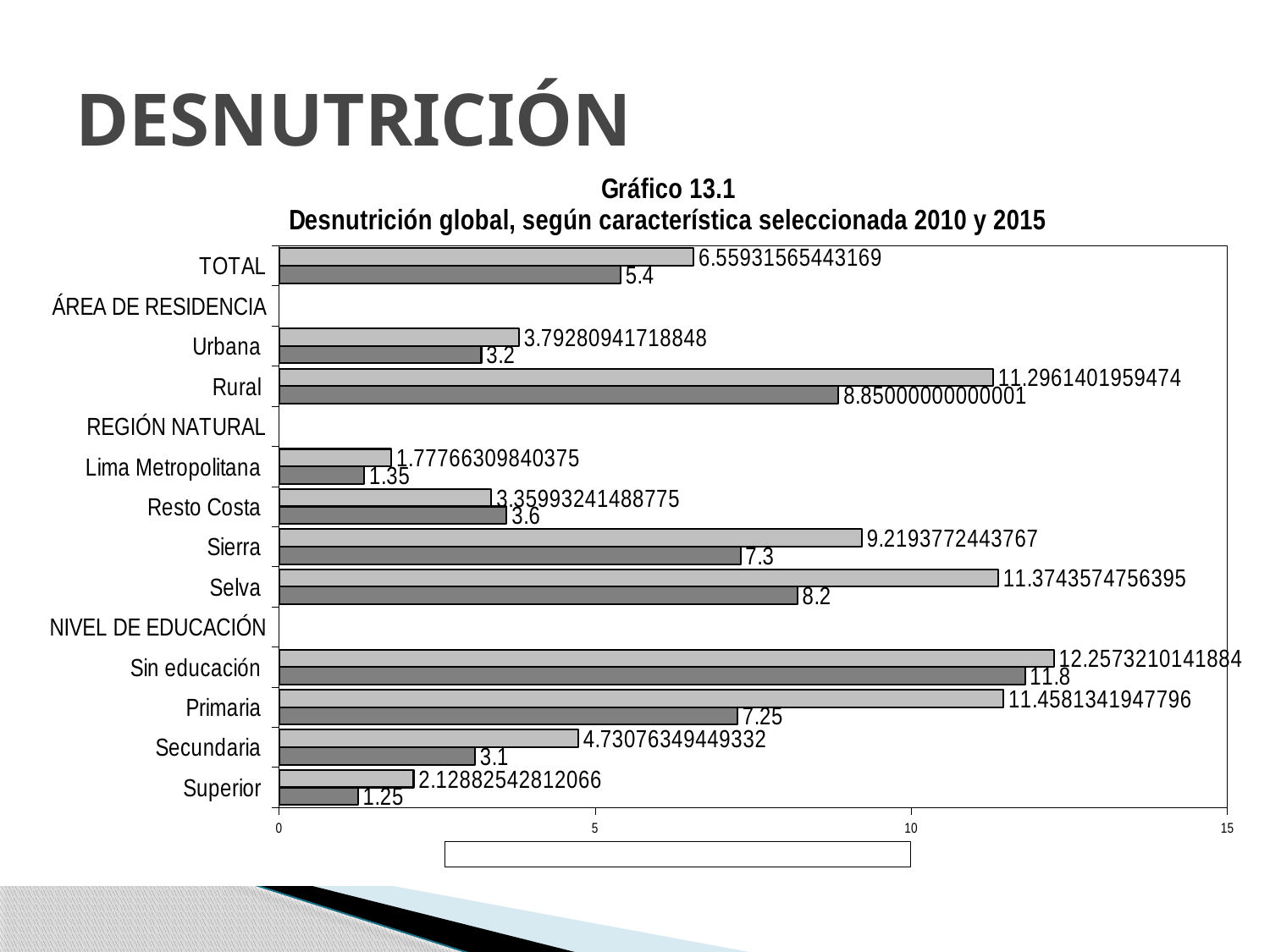
How many categories are listed under NIVEL DE EDUCACIÓN? 4 Is the light grey bar value for Rural greater or less than 10? greater What type of chart is shown on the slide? bar chart What is the value shown on the dark grey bar for Sierra? 7.3 What is the difference between the dark grey bar values for Sin educación and Primaria? 4.55 Which category has the lowest value on its dark grey bar? Superior What is the value shown on the light grey bar for Sin educación? 12.2573210141884 What is the value shown on the dark grey bar for TOTAL? 5.4 What is the number of the chart given in its title? Gráfico 13.1 Which has the larger dark grey bar value, Sierra or Selva? Selva What is the value shown on the dark grey bar for Lima Metropolitana? 1.35 Which category has the highest value on its dark grey bar? Sin educación